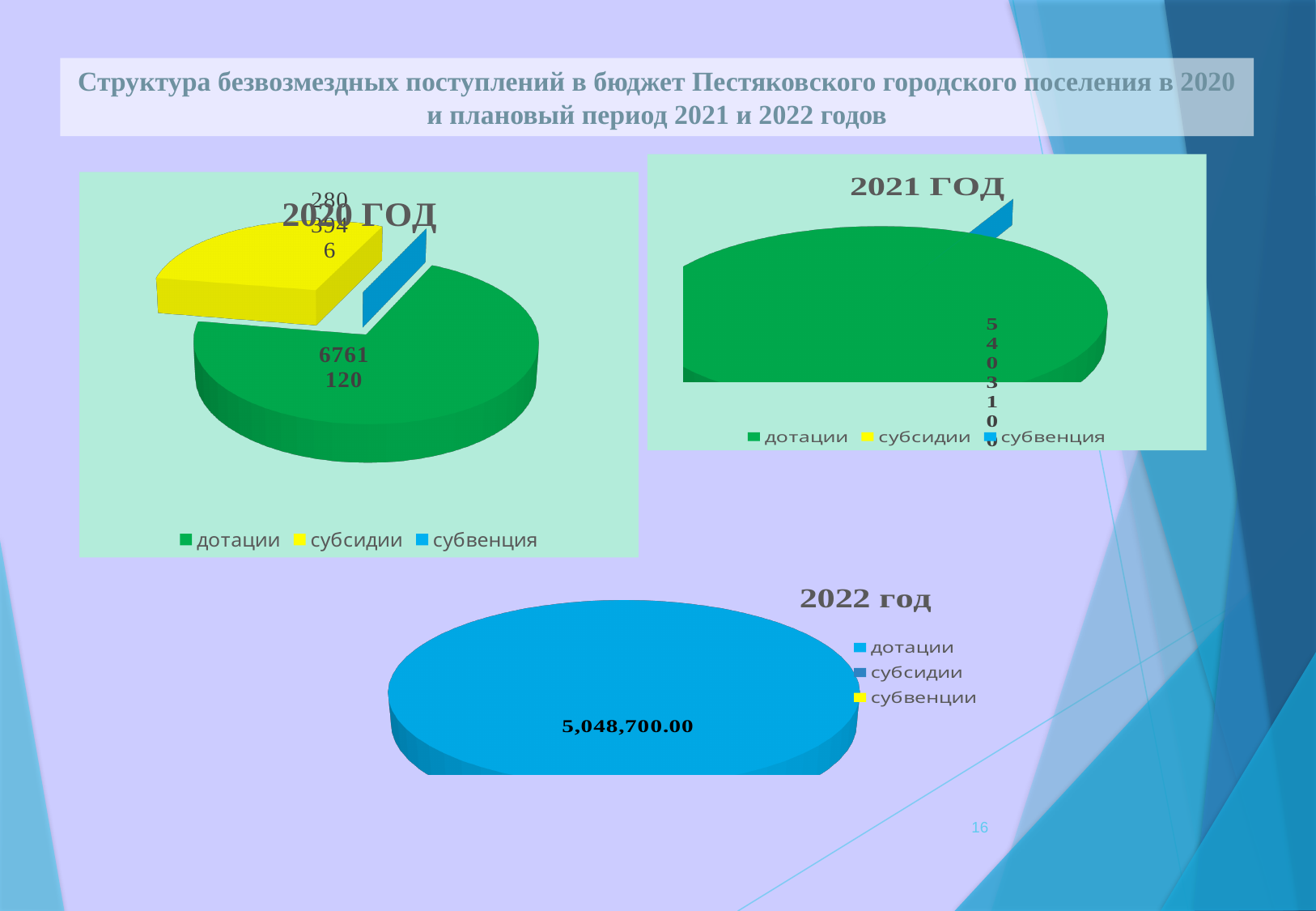
In the 2020 ГОД chart, which category has the smallest slice? субвенция How many entries does the legend of the 2022 год chart list? 3 In the 2021 ГОД chart, what value is printed on the green slice? 5403100 In the 2022 год chart, what value is printed on the pie? 5,048,700.00 What kind of chart is the 2020 ГОД chart? pie chart In the 2021 ГОД chart, which slice is larger, дотации or субвенция? дотации In the 2020 ГОД chart, what colour represents субсидии? yellow How many pie charts are shown on the slide? 3 In the 2020 ГОД chart, which category has the largest slice? дотации In the 2020 ГОД chart, which slice is larger, дотации or субсидии? дотации How many entries does the legend of the 2020 ГОД chart list? 3 In the 2021 ГОД chart, which category has the largest slice? дотации